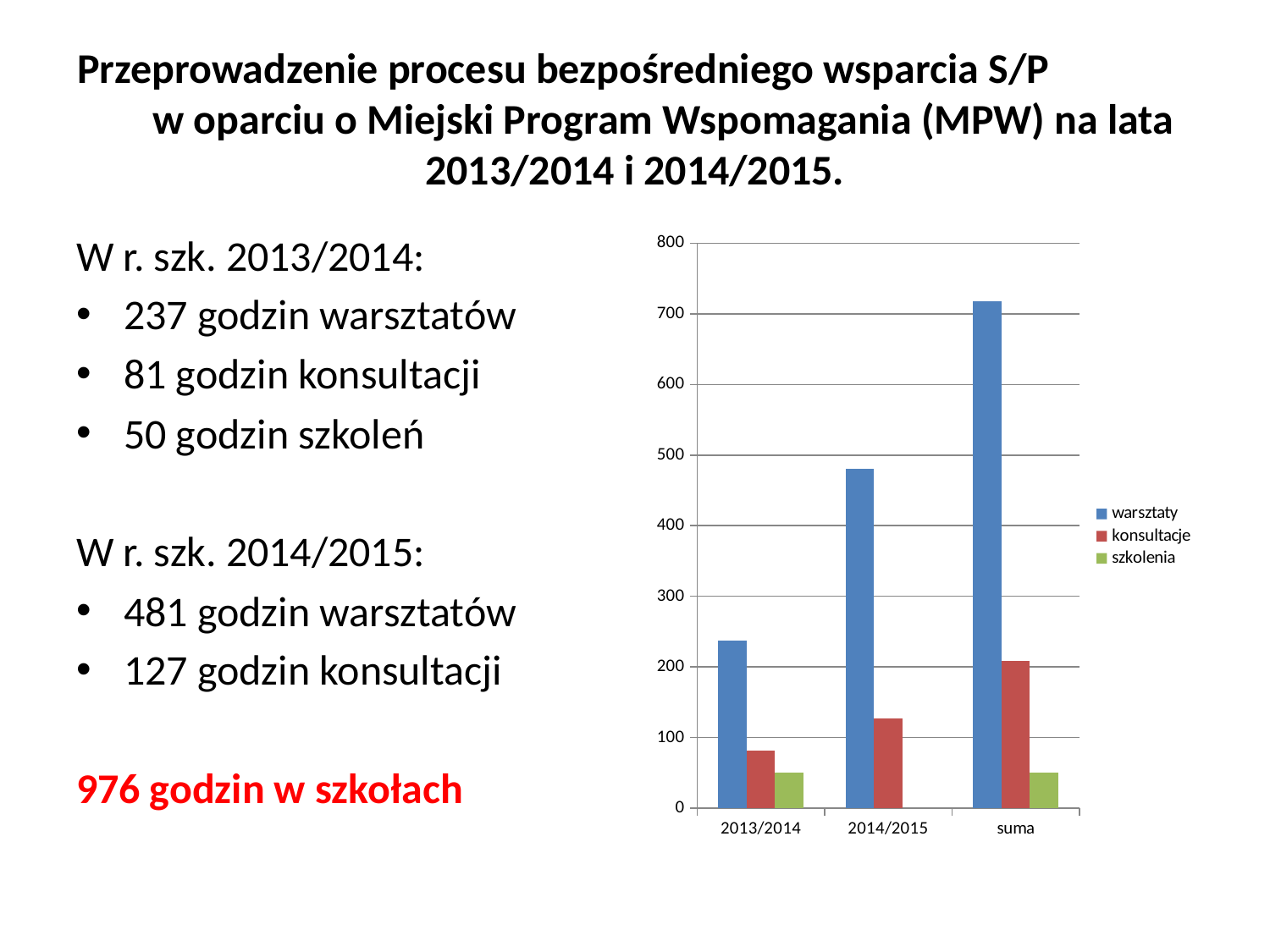
Is the value for warsztaty in suma greater or less than 700? greater Which series has the lowest bar in the 2013/2014 category? szkolenia Is the value for warsztaty in 2013/2014 greater or less than 200? greater How many series does the chart legend list? 3 In 2014/2015, which is larger: warsztaty or konsultacje? warsztaty Is the value for konsultacje in suma greater or less than 300? less How many categories are shown on the x axis of the chart? 3 Which category has the highest warsztaty bar? suma What kind of chart is shown on the slide? bar chart Which colour represents szkolenia in the chart legend? green